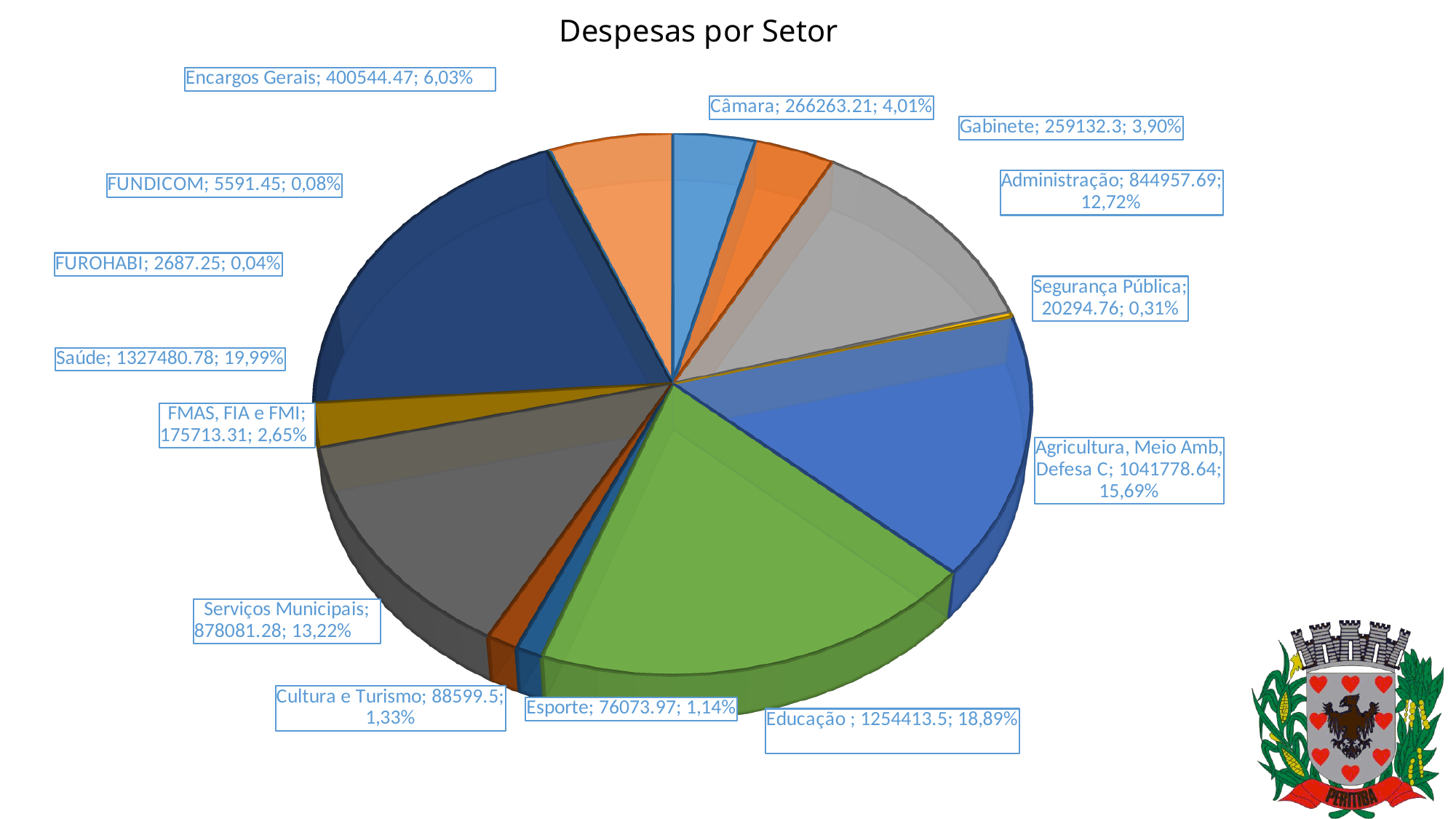
What type of chart is shown on the slide? Pie chart What is the difference between the values for Saúde and Educação? 73067.28 Which is larger, the value for Câmara or the value for Gabinete? Câmara Which sector has the largest expense? Saúde What is the difference between the values for Serviços Municipais and Administração? 33123.59 What is the title of the chart? Despesas por Setor Which sector has the smallest expense? FUROHABI What is the value shown for Saúde? 1327480.78 What percentage share does Agricultura, Meio Amb, Defesa C have? 15,69% How many sectors are shown in the pie chart? 14 What is the value shown for Administração? 844957.69 What percentage share does Educação have? 18,89%